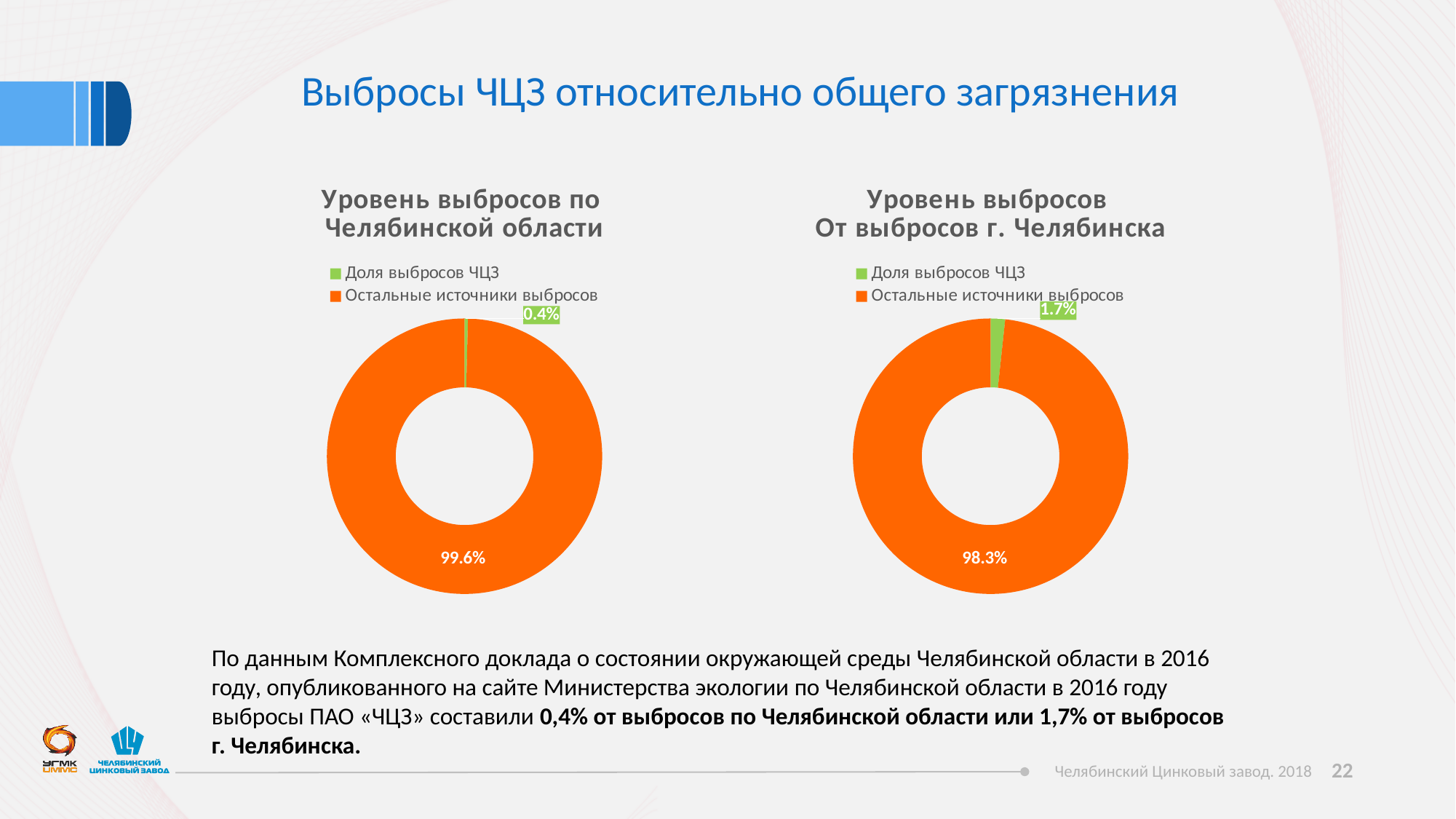
How many entries does the legend of the right chart 'Уровень выбросов От выбросов г. Челябинска' list? 2 In the left chart 'Уровень выбросов по Челябинской области', what is the value for 'Остальные источники выбросов'? 99.6% In the right chart 'Уровень выбросов От выбросов г. Челябинска', which category has the smallest share? Доля выбросов ЧЦЗ How many categories does the left chart 'Уровень выбросов по Челябинской области' show? 2 In the right chart 'Уровень выбросов От выбросов г. Челябинска', what is the value for 'Доля выбросов ЧЦЗ'? 1.7% What kind of chart is the left chart 'Уровень выбросов по Челябинской области'? Doughnut (pie) chart In the left chart 'Уровень выбросов по Челябинской области', which category has the largest share? Остальные источники выбросов Which is larger: 'Доля выбросов ЧЦЗ' in the left chart or 'Доля выбросов ЧЦЗ' in the right chart? The right chart (1.7%) In the right chart 'Уровень выбросов От выбросов г. Челябинска', what is the value for 'Остальные источники выбросов'? 98.3% In the left chart 'Уровень выбросов по Челябинской области', what is the value for 'Доля выбросов ЧЦЗ'? 0.4% In the left chart 'Уровень выбросов по Челябинской области', what is the difference between 'Остальные источники выбросов' and 'Доля выбросов ЧЦЗ'? 99.2% In the right chart 'Уровень выбросов От выбросов г. Челябинска', what colour represents 'Доля выбросов ЧЦЗ'? Green